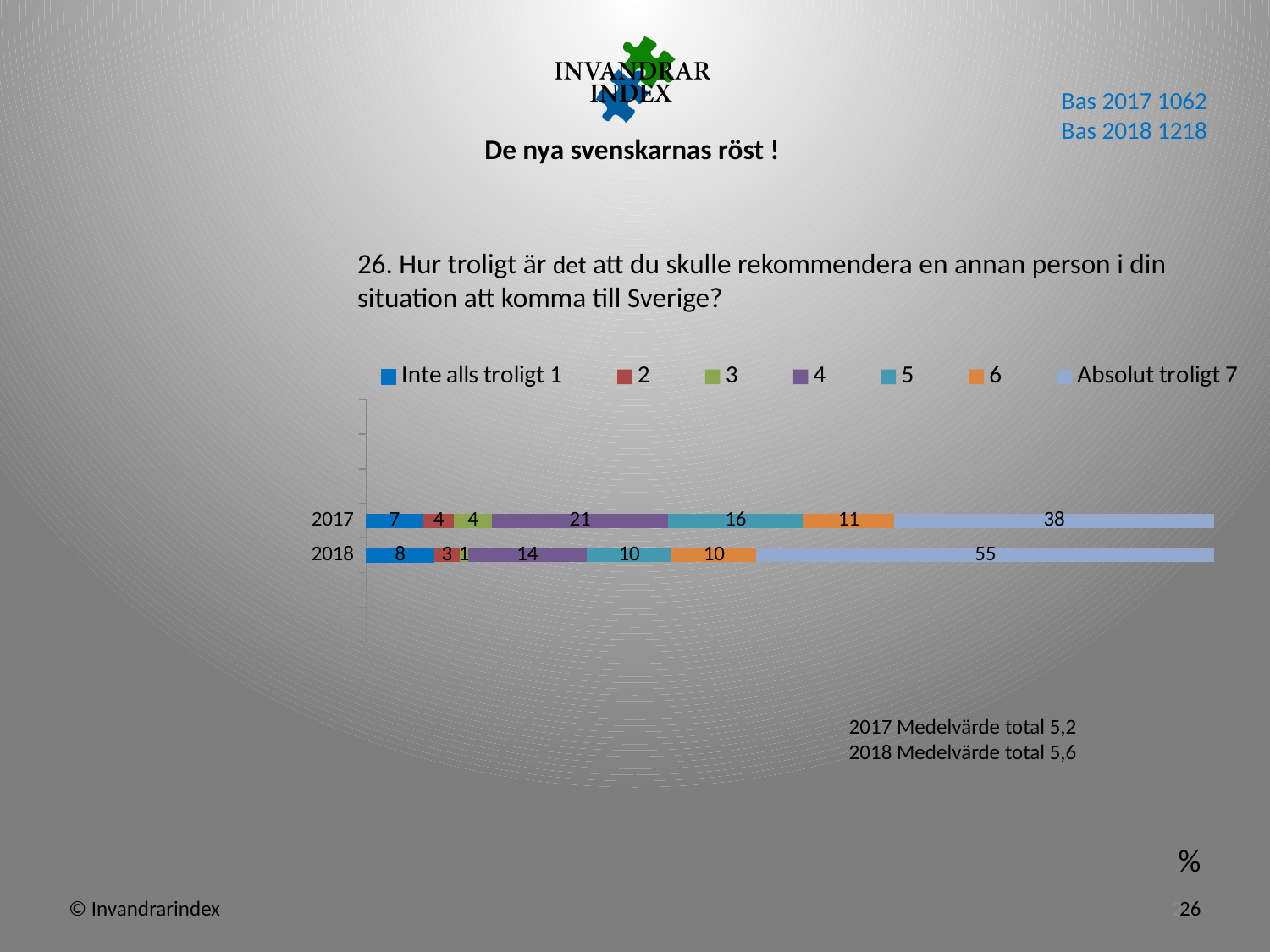
How many categories (years) are shown on the chart? 2 How many series does the legend list? 7 What is the value for 'Absolut troligt 7' in 2018? 55 What is the difference between the 'Absolut troligt 7' values for 2018 and 2017? 17 What is the value for series '5' in 2018? 10 Which is larger: the value for series '4' in 2017 or in 2018? 2017 What kind of chart is shown on the slide? Stacked bar chart What is the value for 'Absolut troligt 7' in 2017? 38 What is the value for 'Inte alls troligt 1' in 2018? 8 Which series has the smallest value in the 2018 bar? 3 Which series has the largest value in the 2018 bar? Absolut troligt 7 What is the value for series '4' in 2017? 21